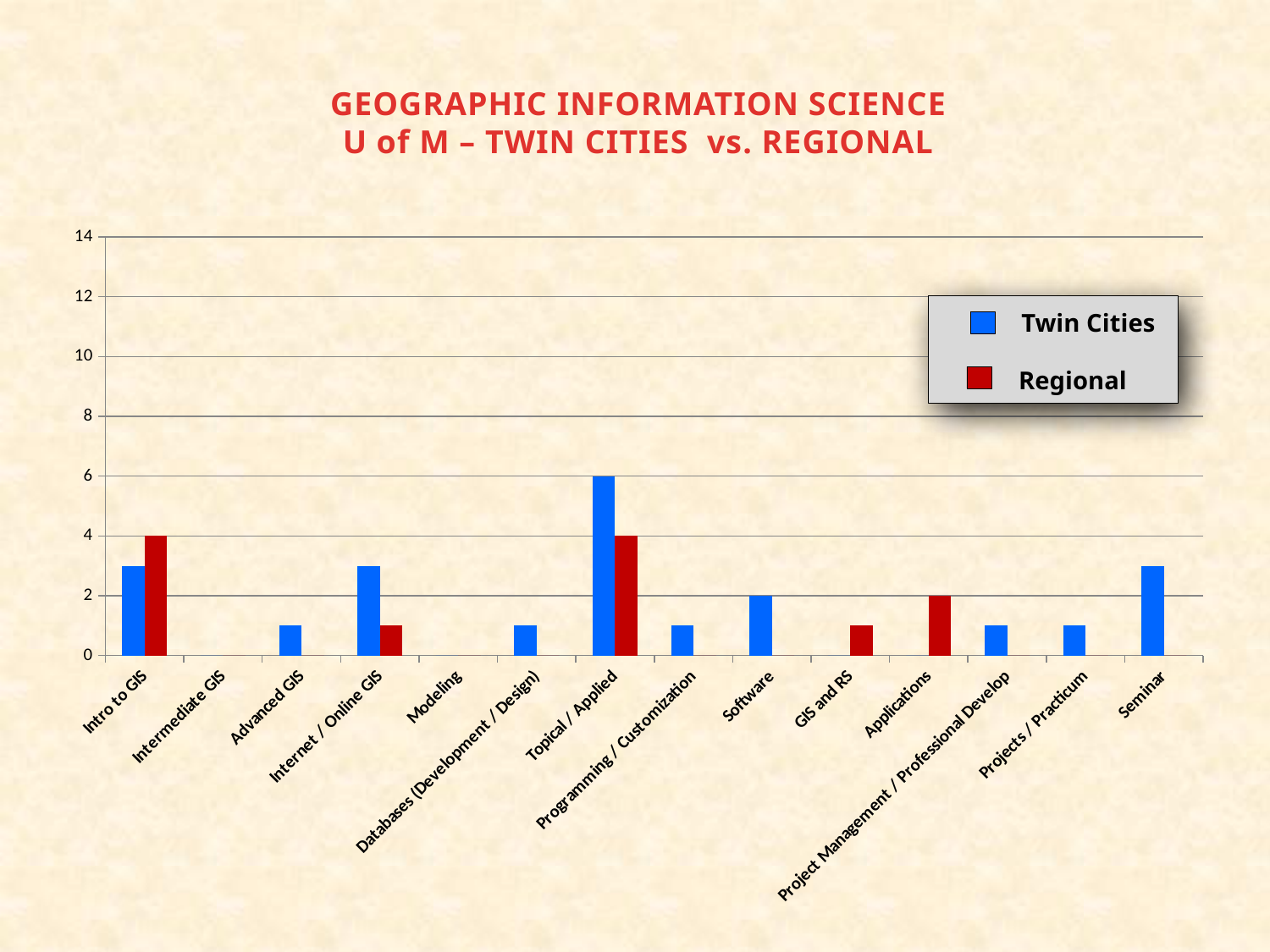
What is the difference between the Twin Cities and Regional values for Topical / Applied? 2 Which category has the highest Twin Cities value? Topical / Applied How many series does the legend list? 2 What is the Regional value for Applications? 2 What is the Twin Cities value for Topical / Applied? 6 What colour represents the Regional series? red Is the Twin Cities value for Seminar greater or less than 2? greater For Intro to GIS, which is larger: the Twin Cities value or the Regional value? Regional What is the Regional value for Intro to GIS? 4 How many categories are shown along the x axis? 14 What is the Twin Cities value for Software? 2 What kind of chart is shown on the slide? bar chart